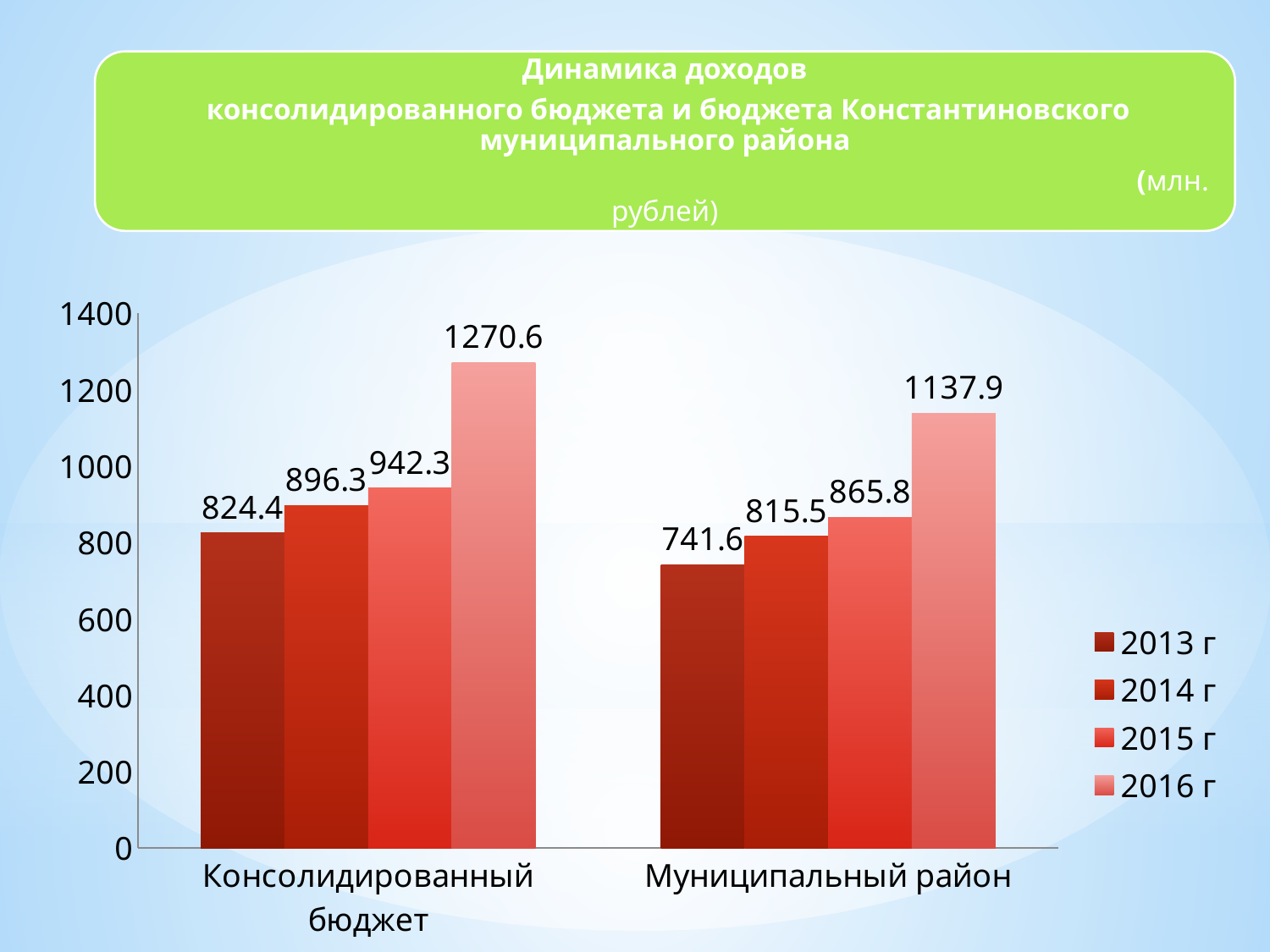
Which is larger: the 2015 г value for Консолидированный бюджет or the 2016 г value for Муниципальный район? 2016 г value for Муниципальный район What kind of chart is shown on the slide? Bar chart What is the difference between the 2016 г and 2015 г values for Консолидированный бюджет? 328.3 What is the difference between the 2014 г values for Консолидированный бюджет and Муниципальный район? 80.8 What is the value for 2014 г in the Муниципальный район category? 815.5 What is the value for 2013 г in the Муниципальный район category? 741.6 What is the value for 2016 г in the Консолидированный бюджет category? 1270.6 Which year has the lowest value in the Консолидированный бюджет category? 2013 г How many series does the legend list? 4 Do the values for Муниципальный район rise or fall from 2013 г to 2016 г? Rise Which year has the highest value in the Муниципальный район category? 2016 г What is the value for 2015 г in the Консолидированный бюджет category? 942.3